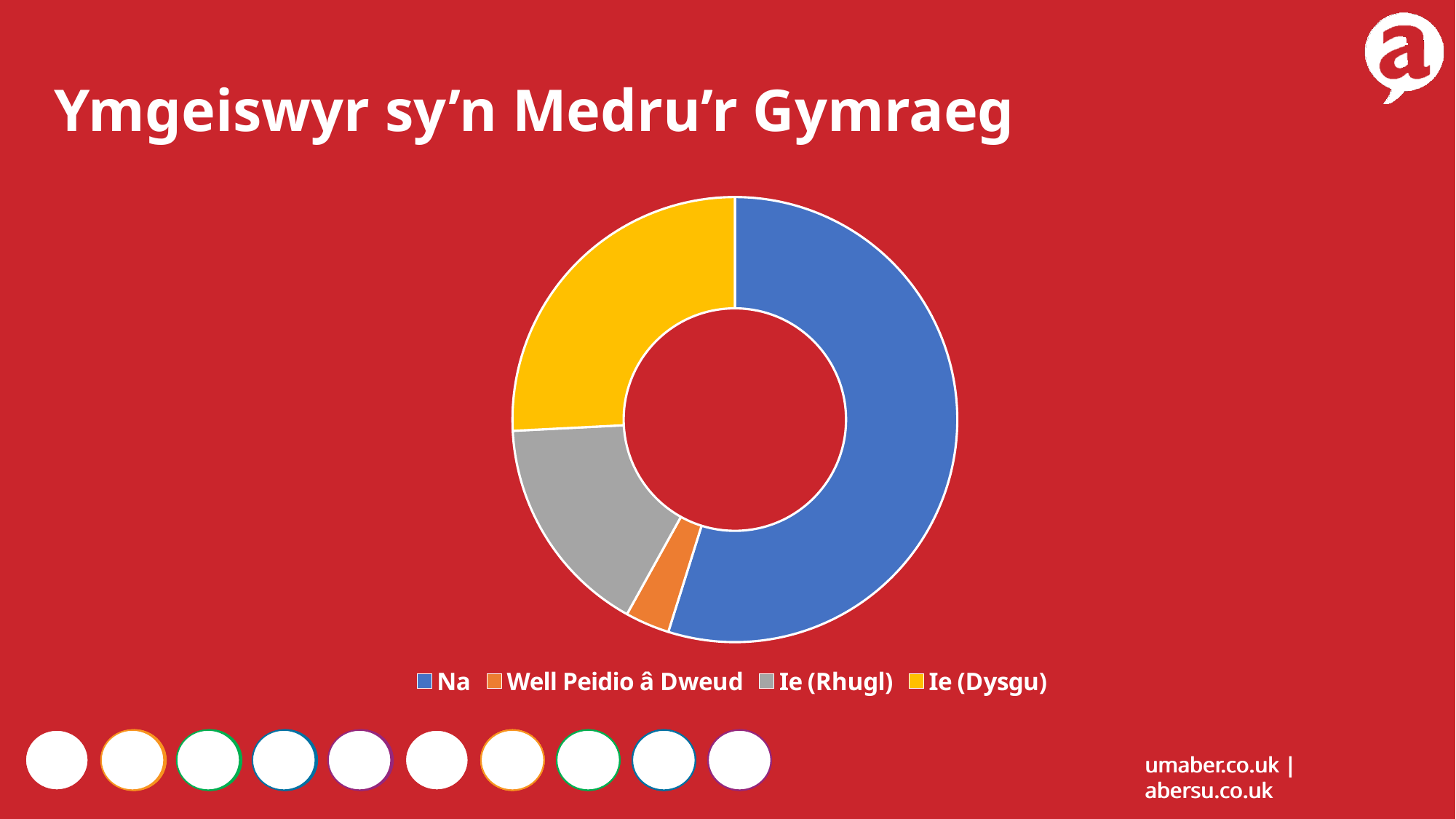
What is the title of the slide containing the chart? Ymgeiswyr sy'n Medru'r Gymraeg Does the Na segment account for more or less than half of the chart? more Which is larger, the share for Na or the share for Ie (Dysgu)? Na What colour represents the Ie (Dysgu) category in the chart? Yellow What kind of chart is shown on the slide? Doughnut (pie) chart Which is larger, the share for Ie (Rhugl) or the share for Well Peidio â Dweud? Ie (Rhugl) How many categories does the chart's legend list? 4 Which is larger, the share for Ie (Dysgu) or the share for Ie (Rhugl)? Ie (Dysgu) Which category takes up the largest share of the chart? Na Which category takes up the smallest share of the chart? Well Peidio â Dweud Does the Well Peidio â Dweud segment account for more or less than a quarter of the chart? less